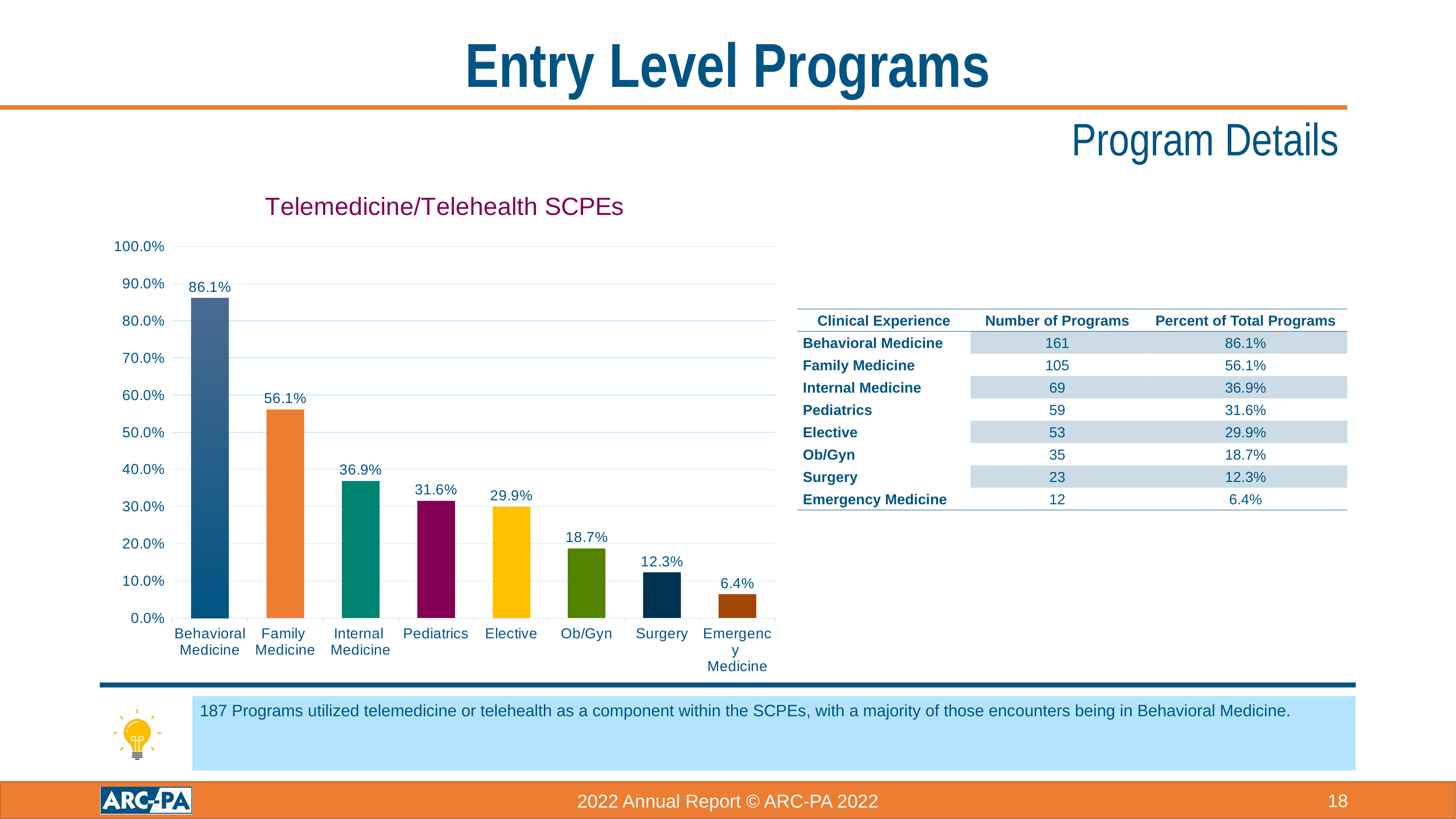
Which category has the highest value in the Telemedicine/Telehealth SCPEs chart? Behavioral Medicine Is the value for Family Medicine in the Telemedicine/Telehealth SCPEs chart greater or less than 50.0%? greater How many categories are shown in the Telemedicine/Telehealth SCPEs chart? 8 Do the values in the Telemedicine/Telehealth SCPEs chart rise or fall from left to right along the x axis? fall What is the difference between the values for Behavioral Medicine and Family Medicine in the Telemedicine/Telehealth SCPEs chart? 30.0% What is the value for Elective in the Telemedicine/Telehealth SCPEs chart? 29.9% Which is larger in the Telemedicine/Telehealth SCPEs chart, Internal Medicine or Pediatrics? Internal Medicine What is the difference between the values for Surgery and Emergency Medicine in the Telemedicine/Telehealth SCPEs chart? 5.9% Which category has the lowest value in the Telemedicine/Telehealth SCPEs chart? Emergency Medicine What is the value for Behavioral Medicine in the Telemedicine/Telehealth SCPEs chart? 86.1% What kind of chart is the Telemedicine/Telehealth SCPEs chart? bar chart What is the value for Ob/Gyn in the Telemedicine/Telehealth SCPEs chart? 18.7%